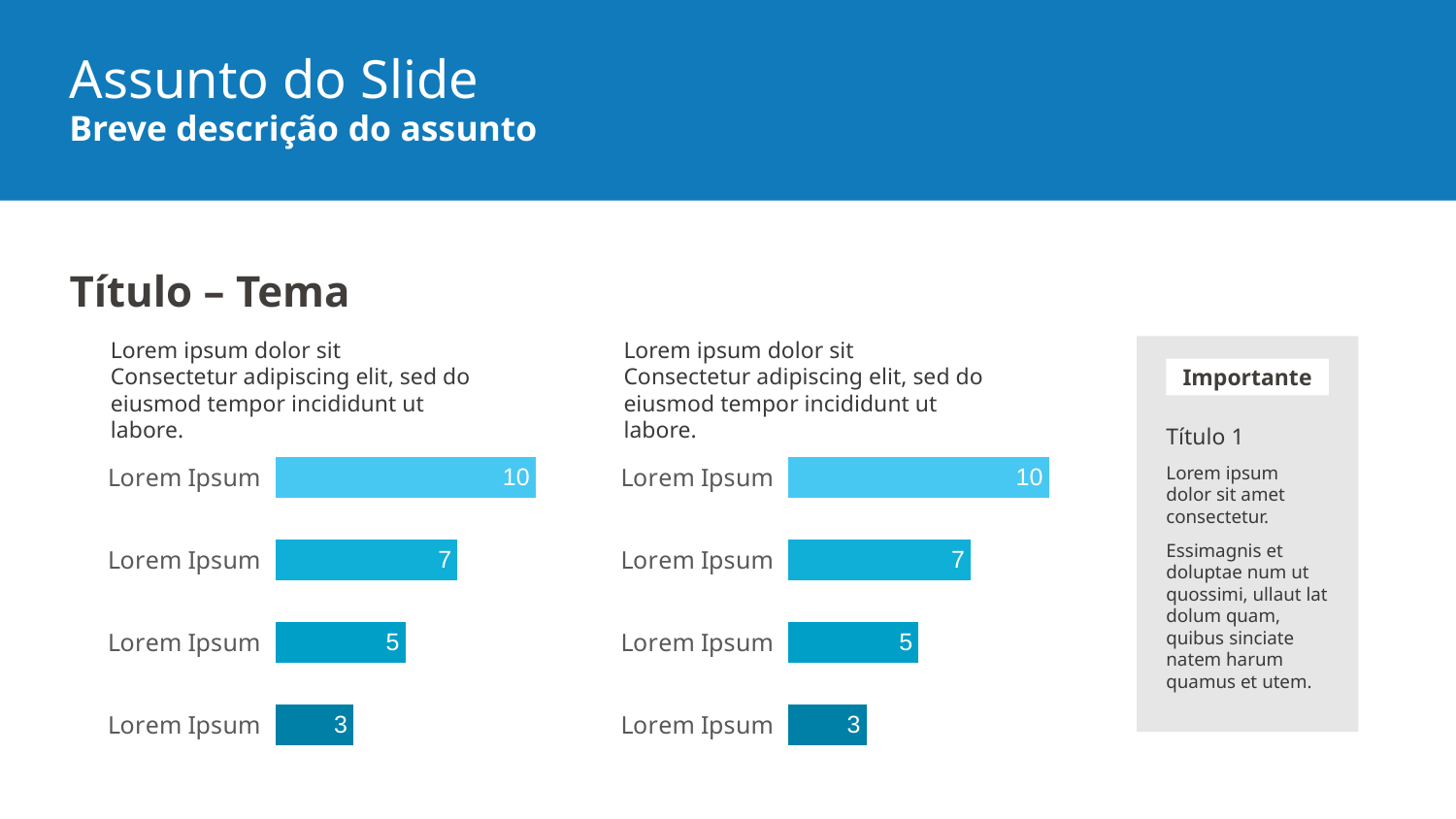
In the right chart, what is the lowest value shown? 3 In the left chart, do the bar values increase or decrease from top to bottom? decrease In the left chart, what is the value of the top bar? 10 In the right chart, which is larger: the second bar from the top or the third bar from the top? the second bar from the top In the right chart, what is the value of the second bar from the top? 7 In the left chart, what is the difference between the top bar and the bottom bar? 7 In the right chart, what is the value of the third bar from the top? 5 What kind of chart is the left chart on the slide? bar chart How many bars does the right chart have? 4 In the left chart, what is the value of the bottom bar? 3 How many bars does the left chart have? 4 In the left chart, what is the highest value shown? 10